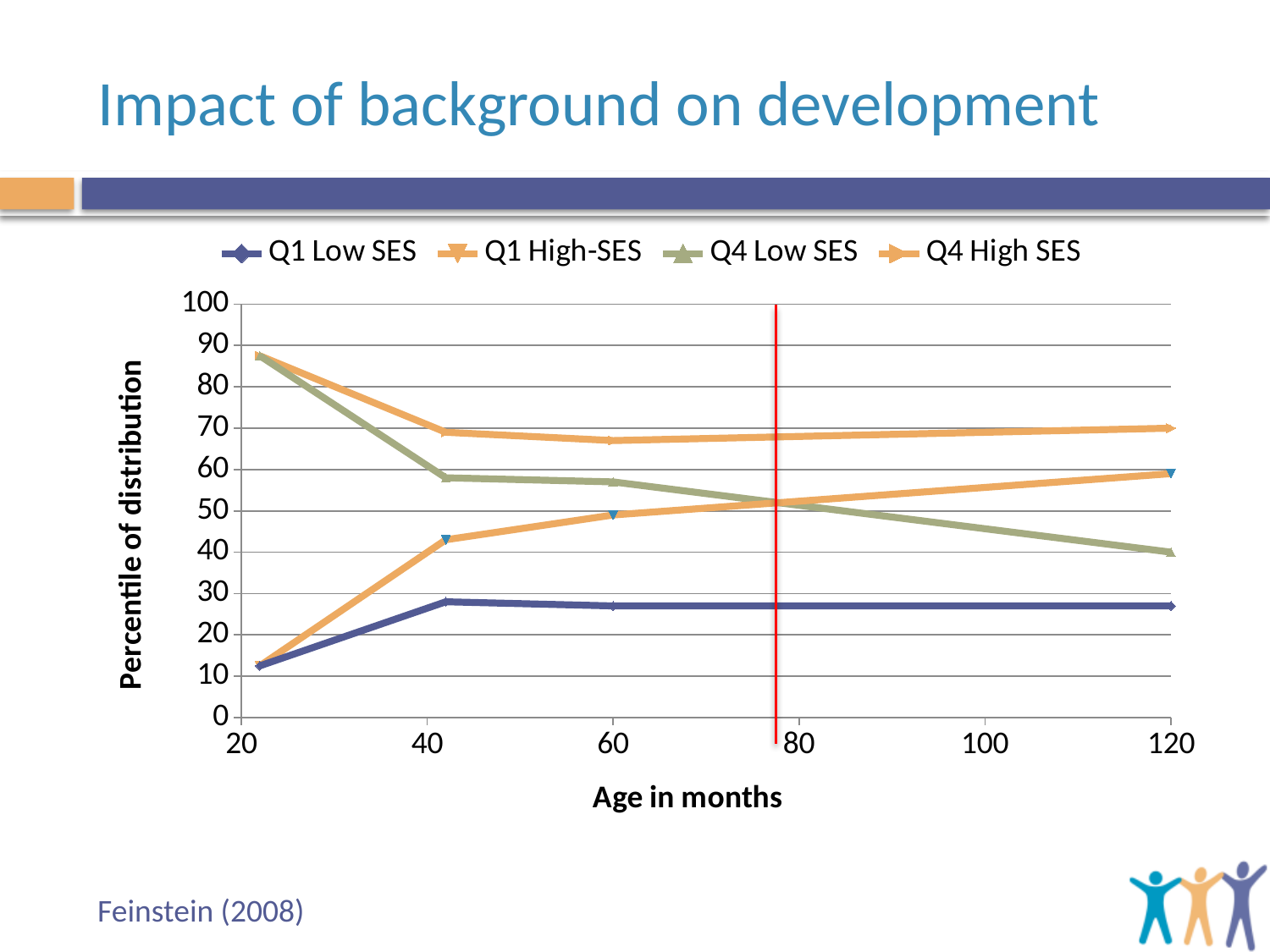
What kind of chart is shown on the slide? line chart Is the value for Q1 Low SES at 120 months greater or less than 30? less Is the value for Q4 High SES at 120 months greater or less than 60? greater Does the Q1 High-SES line rise or fall as age in months increases? rise How many series does the legend list? 4 Is the value for Q4 Low SES at 120 months greater or less than 50? less At 120 months, which is larger: Q4 High SES or Q4 Low SES? Q4 High SES What is the title of the horizontal axis? Age in months Does the Q4 Low SES line rise or fall as age in months increases? fall Which series has the highest value at 120 months? Q4 High SES At 120 months, which is larger: Q1 High-SES or Q4 Low SES? Q1 High-SES Which series has the lowest value at 120 months? Q1 Low SES